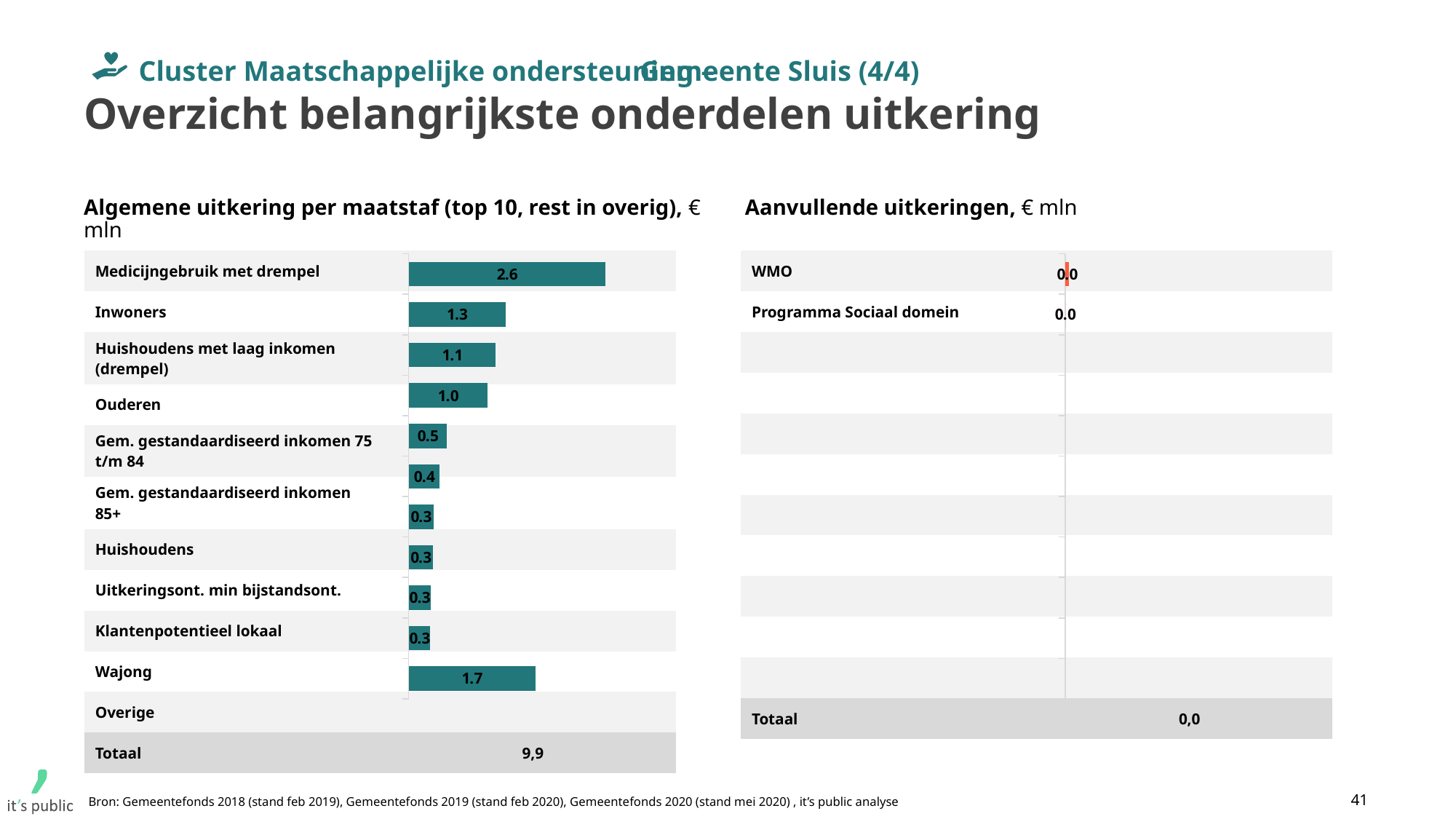
In the chart 'Algemene uitkering per maatstaf', which category has the highest value? Medicijngebruik met drempel In the chart 'Algemene uitkering per maatstaf', what is the value for Ouderen? 1.0 What kind of chart is 'Algemene uitkering per maatstaf'? Bar chart In the chart 'Algemene uitkering per maatstaf', what is the difference between the values for Medicijngebruik met drempel and Inwoners? 1.3 In the chart 'Algemene uitkering per maatstaf', which is larger: Inwoners or Ouderen? Inwoners In the chart 'Aanvullende uitkeringen', what is the value for WMO? 0.0 In the chart 'Algemene uitkering per maatstaf', what is the value for Inwoners? 1.3 In the chart 'Aanvullende uitkeringen', what is the Totaal shown? 0,0 In the chart 'Algemene uitkering per maatstaf', what is the value for Medicijngebruik met drempel? 2.6 How many labelled categories does the chart 'Aanvullende uitkeringen' show (excluding Totaal)? 2 In the chart 'Algemene uitkering per maatstaf', what is the value for Huishoudens met laag inkomen (drempel)? 1.1 In the chart 'Algemene uitkering per maatstaf', what is the Totaal shown? 9,9